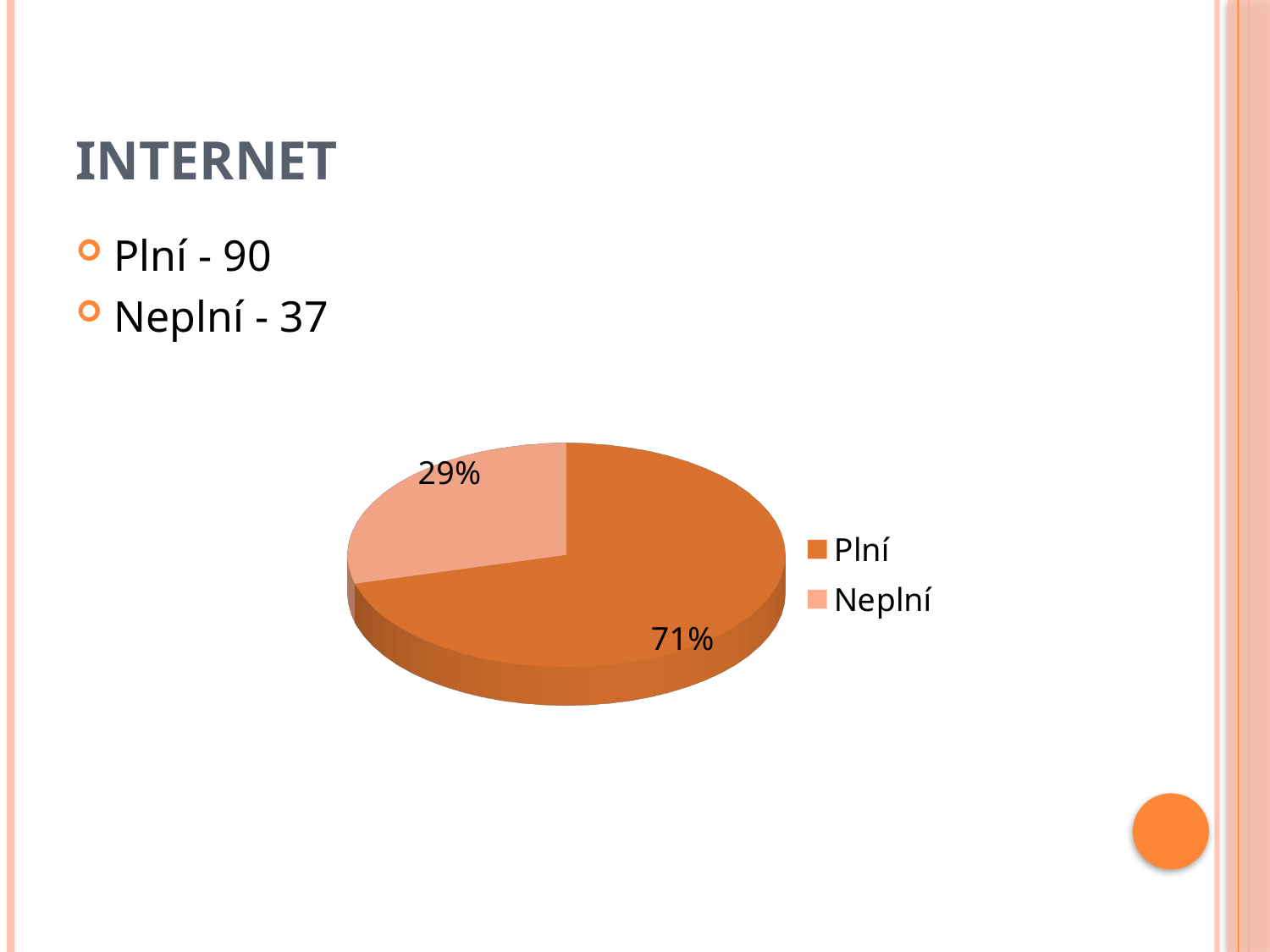
Which slice of the pie chart is the smallest? Neplní How many slices does the pie chart have? 2 Which slice of the pie chart is the largest? Plní What type of chart is shown on the slide? Pie chart Which legend entry is shown in the lighter orange colour? Neplní What is the title of the slide containing the chart? INTERNET Which slice is larger in the pie chart, Plní or Neplní? Plní What percentage of the pie chart does the Plní slice represent? 71% What percentage of the pie chart does the Neplní slice represent? 29% How many entries does the chart legend list? 2 What is the difference in percentage points between the Plní and Neplní slices? 42